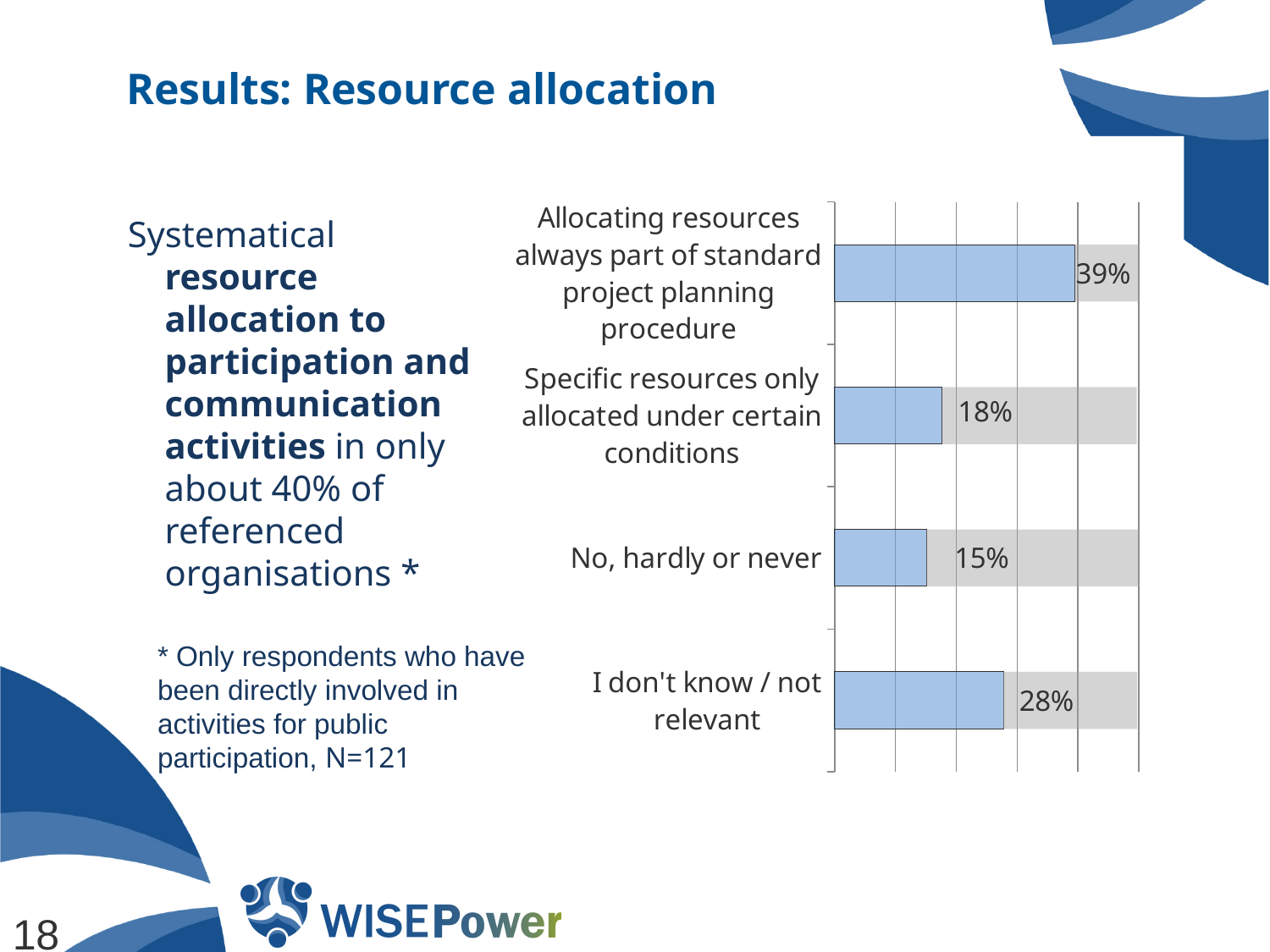
Which is larger: the value for "I don't know / not relevant" or the value for "Specific resources only allocated under certain conditions"? I don't know / not relevant What is the value for "No, hardly or never"? 15% What kind of chart is shown on the slide? Bar chart What is the difference between the values for "Allocating resources always part of standard project planning procedure" and "I don't know / not relevant"? 11% Which category has the highest value? Allocating resources always part of standard project planning procedure What is the value for "I don't know / not relevant"? 28% What is the difference between the values for "Specific resources only allocated under certain conditions" and "No, hardly or never"? 3% What is the sample size (N) stated in the footnote below the chart text? N=121 What is the value for "Allocating resources always part of standard project planning procedure"? 39% Which category has the lowest value? No, hardly or never What is the value for "Specific resources only allocated under certain conditions"? 18% How many categories are shown in the chart? 4